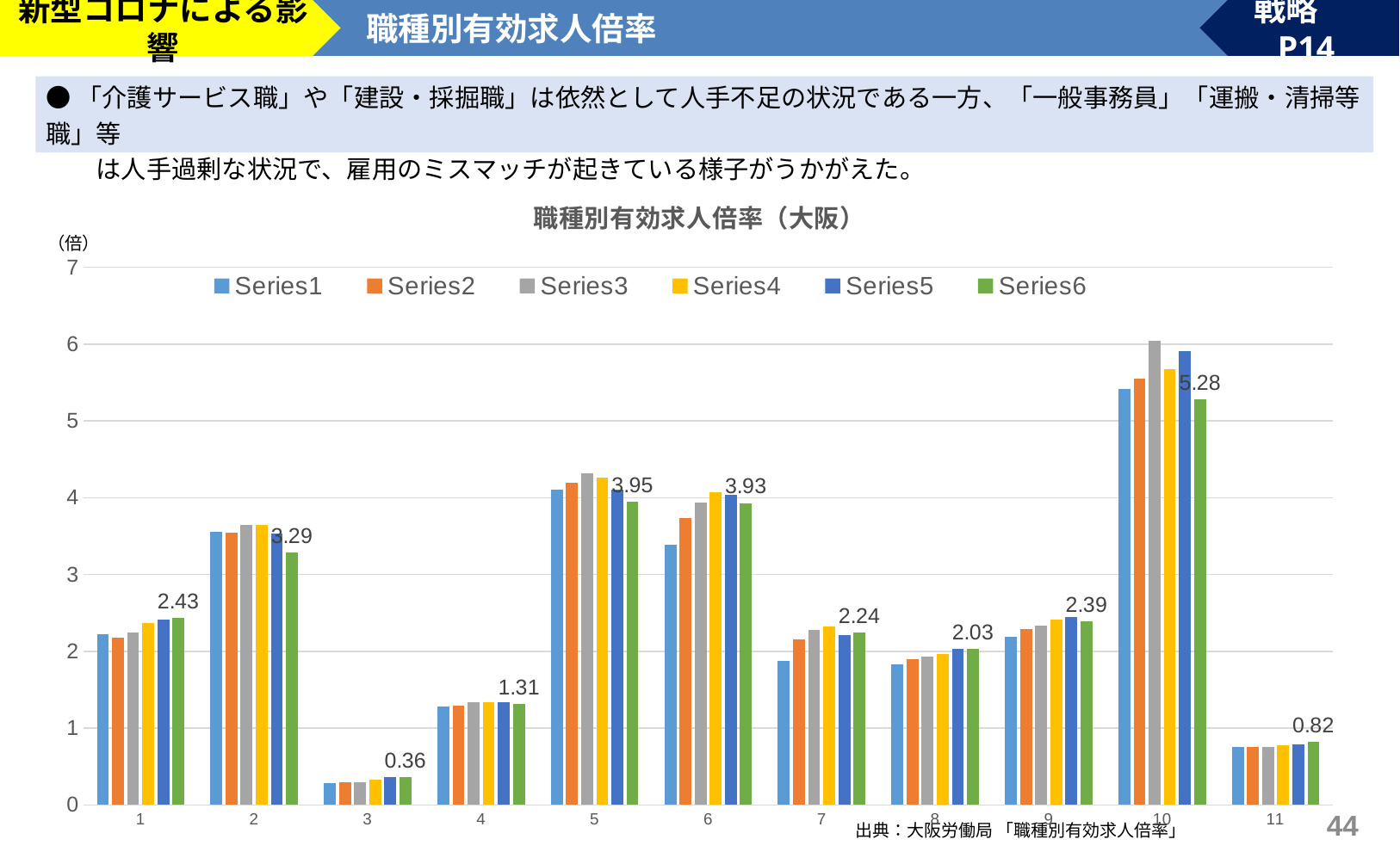
Is the Series3 value for category 10 greater or less than 5? greater What is the Series6 value for category 10? 5.28 How many categories are shown on the x axis? 11 How many series does the legend list? 6 Is the Series6 value for category 2 larger or smaller than the Series6 value for category 9? larger What is the difference between the Series6 values for category 10 and category 11? 4.46 Which category has the lowest Series6 value? 3 What is the Series6 value for category 1? 2.43 What type of chart is shown on the slide? bar chart What is the Series6 value for category 11? 0.82 What is the Series6 value for category 3? 0.36 Which category has the highest Series6 value? 10